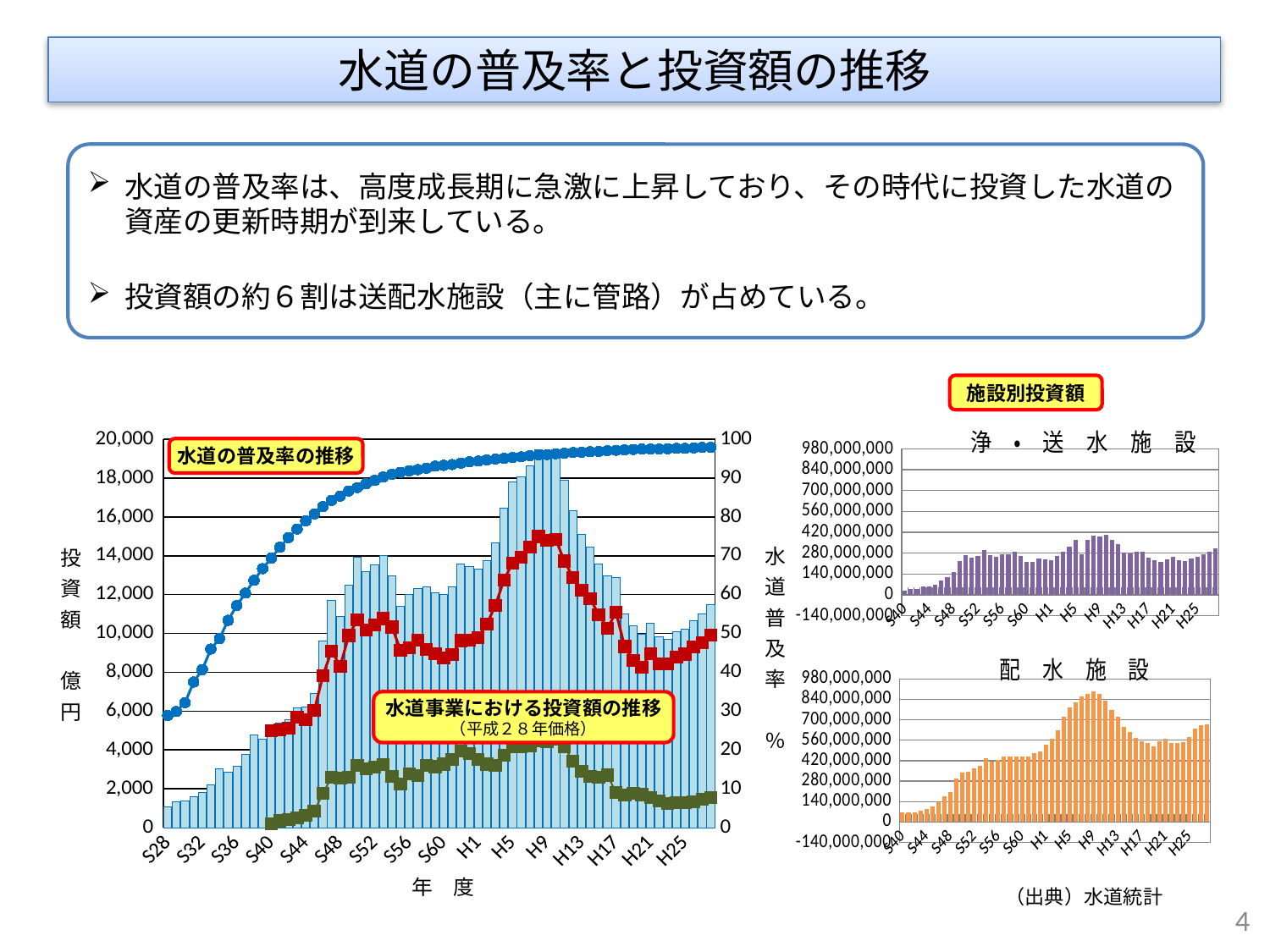
In the large chart on the left, is the 水道普及率 value at S36 greater or less than 50? greater In the large chart on the left, is the investment bar at S28 greater or less than 2,000? less In the large chart on the left, is the 水道普及率 value at H25 greater or less than 90? greater What kind of chart is the 浄・送水施設 chart on the right side of the slide? bar chart In the 配水施設 chart, do the values rise or fall from H9 to H17? fall How many charts are shown on the slide? 3 What is the highest tick value on the right-hand axis of the large chart on the left? 100 In the large chart on the left, does the blue line (水道普及率) rise or fall from S28 to H25? rise At H9, which is larger: the value in the 配水施設 chart or the value in the 浄・送水施設 chart? 配水施設